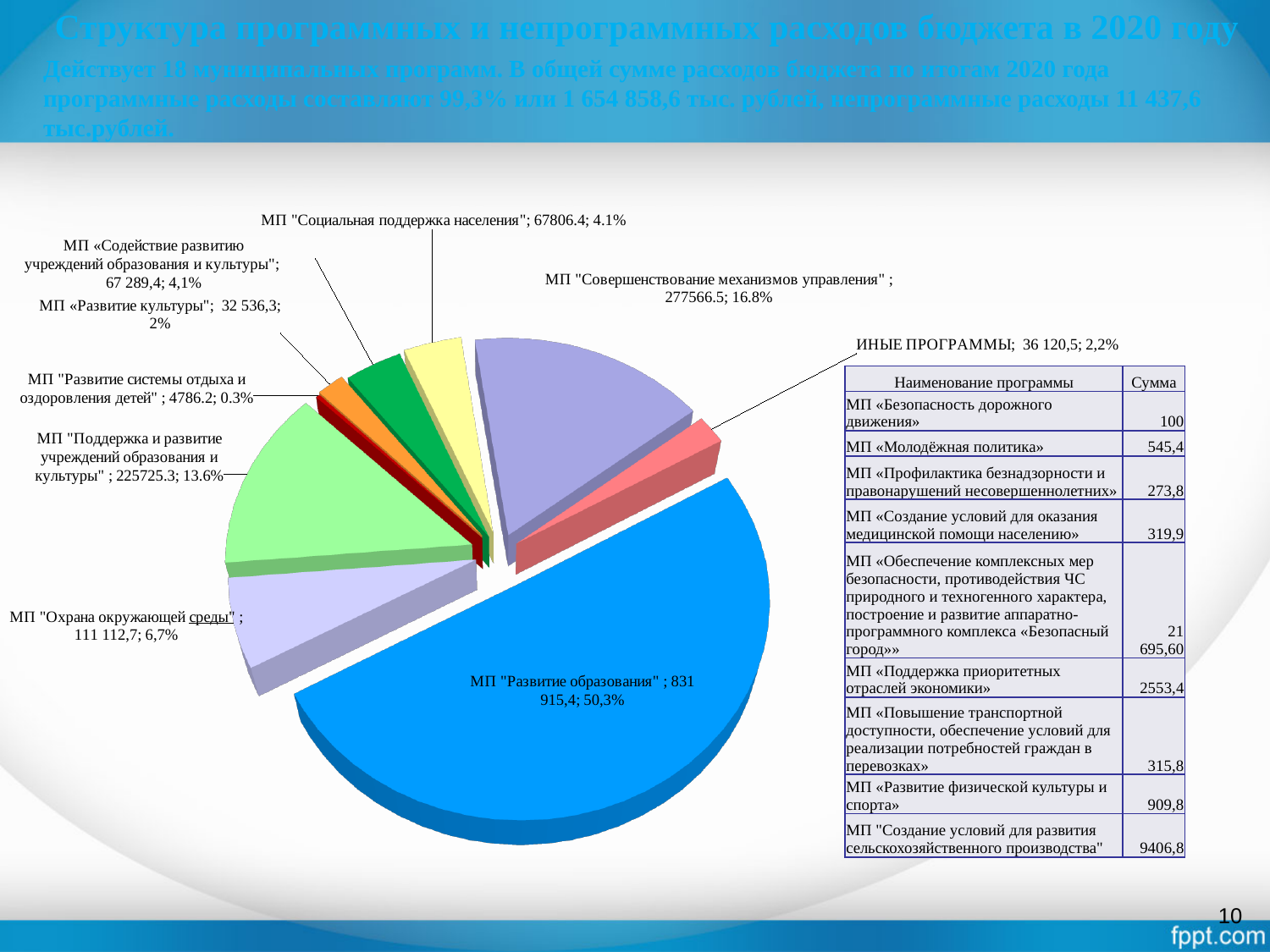
What percentage is shown for МП «Развитие культуры»? 2% What is the difference in percentage points between the shares of МП "Развитие образования" and МП "Совершенствование механизмов управления"? 33,5% What is the value shown for МП "Охрана окружающей среды"? 111 112,7 How many slices does the pie chart have? 9 Which program has the smallest share of the pie chart? МП "Развитие системы отдыха и оздоровления детей" What type of chart is shown on the slide? Pie chart Which has a larger share: МП "Охрана окружающей среды" or МП "Социальная поддержка населения"? МП "Охрана окружающей среды" Which program has the largest share of the pie chart? МП "Развитие образования" What percentage is shown for МП "Поддержка и развитие учреждений образования и культуры"? 13.6% What share of the pie does МП "Развитие образования" account for? 50,3% What is the value shown for ИНЫЕ ПРОГРАММЫ? 36 120,5 What is the value shown for МП "Совершенствование механизмов управления"? 277566.5